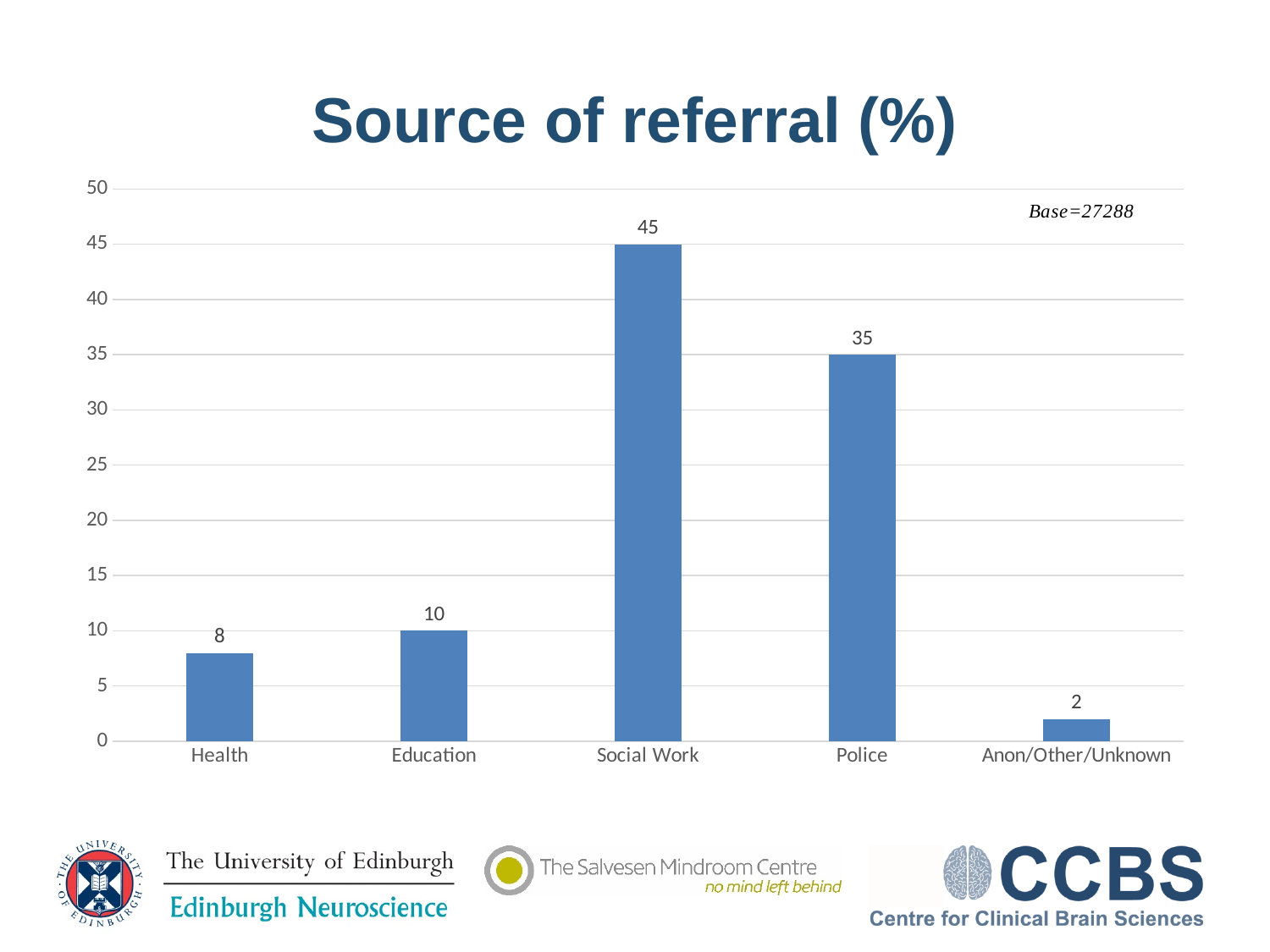
How many categories are shown on the x axis? 5 Which source of referral has the lowest value? Anon/Other/Unknown What is the title of the chart? Source of referral (%) Which is larger, the value for Education or the value for Health? Education What is the value for Health? 8 What is the value for Police? 35 What is the value for Anon/Other/Unknown? 2 What is the value for Social Work? 45 Which source of referral has the highest value? Social Work What is the difference between the values for Social Work and Police? 10 Is the value for Police greater or less than 30? greater What kind of chart is shown on the slide? Bar chart